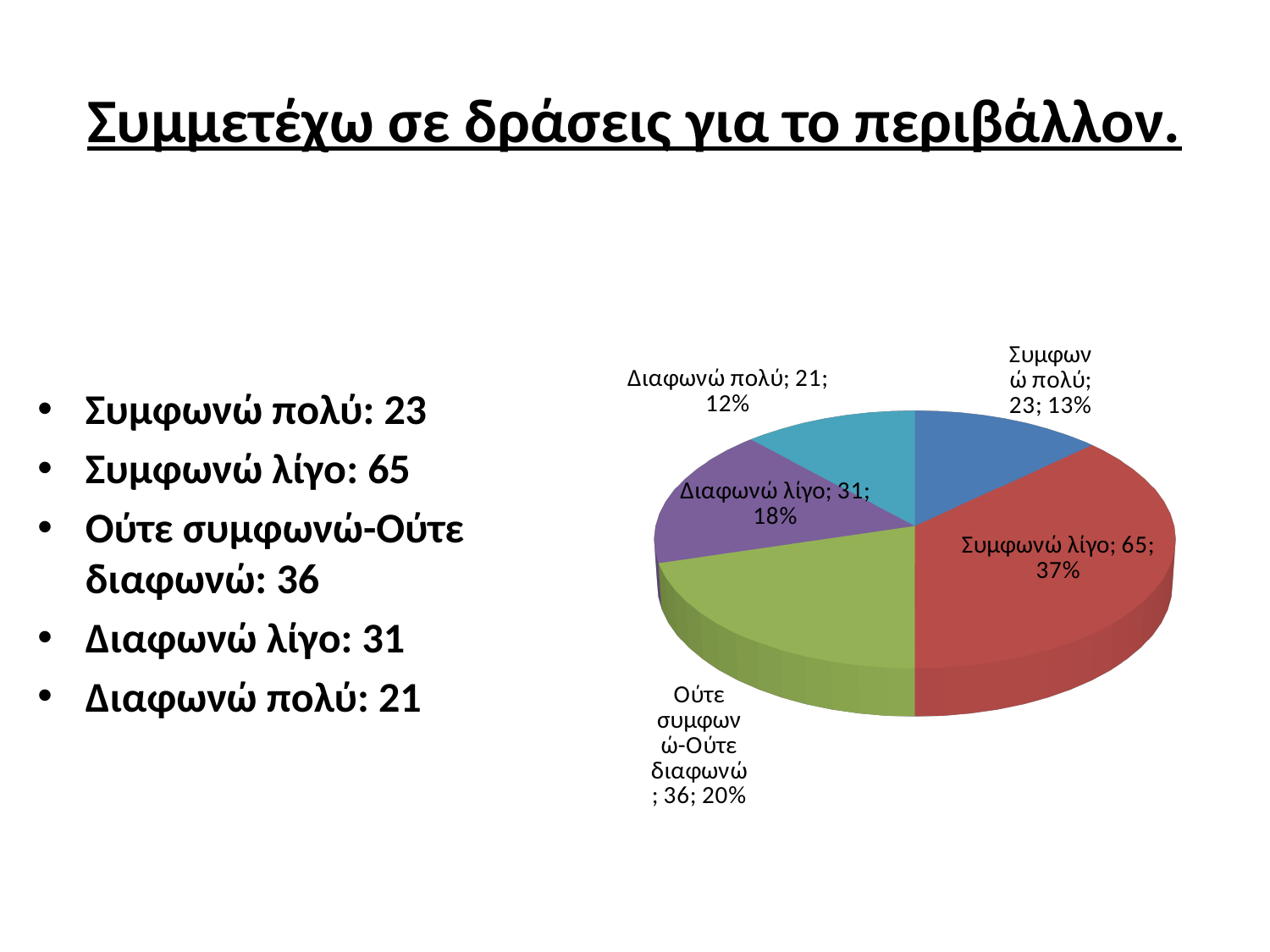
What colour is the Συμφωνώ λίγο slice? red What percentage share does the Διαφωνώ λίγο slice have? 18% Which is larger, the value for Διαφωνώ λίγο or the value for Διαφωνώ πολύ? Διαφωνώ λίγο Which category has the smallest slice of the pie? Διαφωνώ πολύ What is the value for Ούτε συμφωνώ-Ούτε διαφωνώ? 36 What is the difference between the values for Συμφωνώ λίγο and Συμφωνώ πολύ? 42 What percentage share does the Συμφωνώ πολύ slice have? 13% What kind of chart is shown on the slide? pie chart How many slices does the pie chart have? 5 What is the value for Συμφωνώ λίγο in the pie chart? 65 Which category has the largest slice of the pie? Συμφωνώ λίγο What is the total of all the values shown in the pie chart? 176